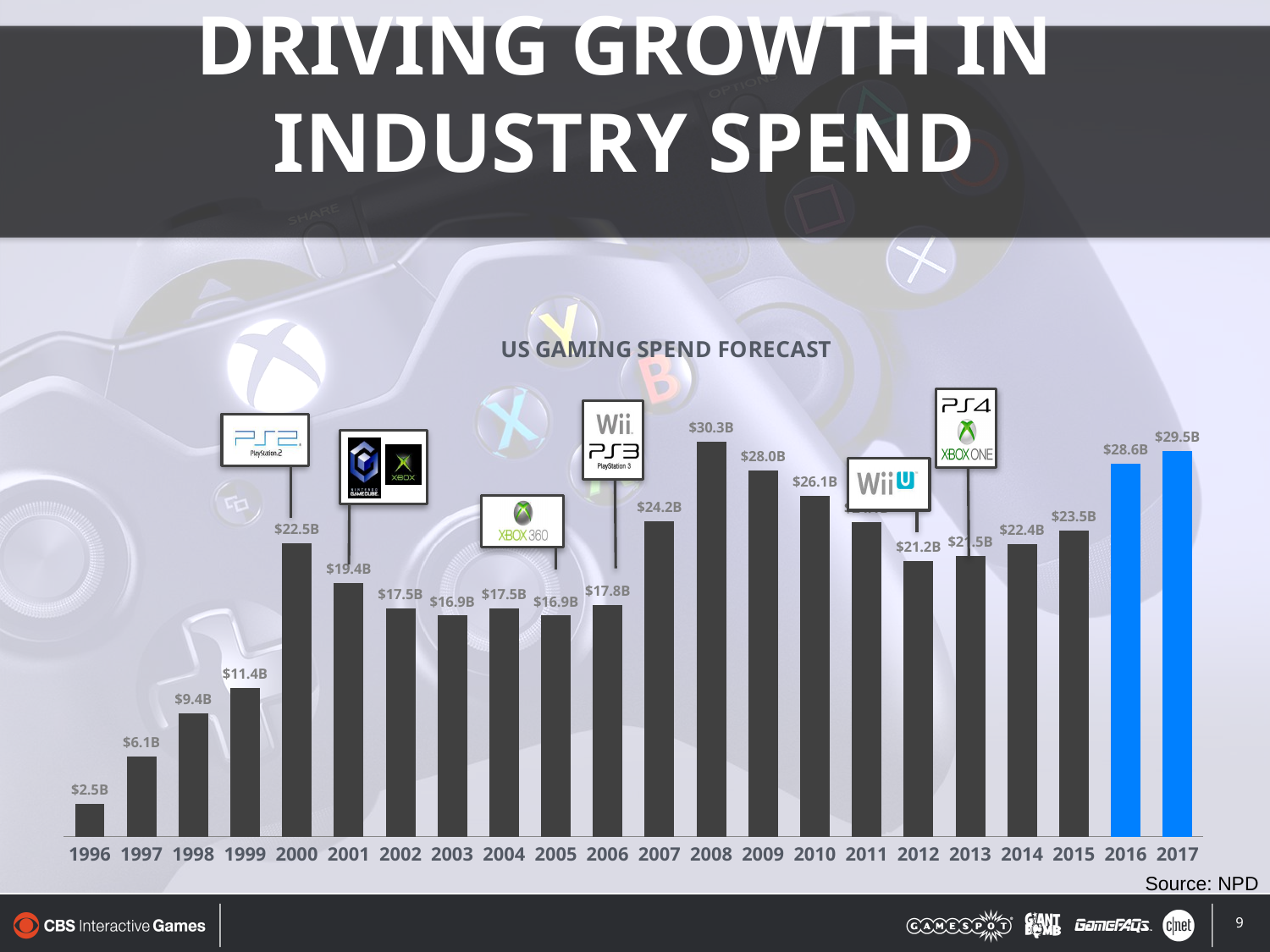
What is the US gaming spend value shown for 2008? $30.3B What is the value shown for 2000? $22.5B What is the difference between the 2017 value and the 2016 value? $0.9B How many years are shown on the x axis of the chart? 22 What is the difference between the 2008 value and the 2007 value? $6.1B What is the value shown for 1996? $2.5B What is the forecast value shown for 2017? $29.5B Which is larger, the value for 2009 or the value for 2010? 2009 What kind of chart is shown on the slide? Bar chart Which year has the highest value in the chart? 2008 Which year has the lowest value in the chart? 1996 What is the title of the chart? US Gaming Spend Forecast